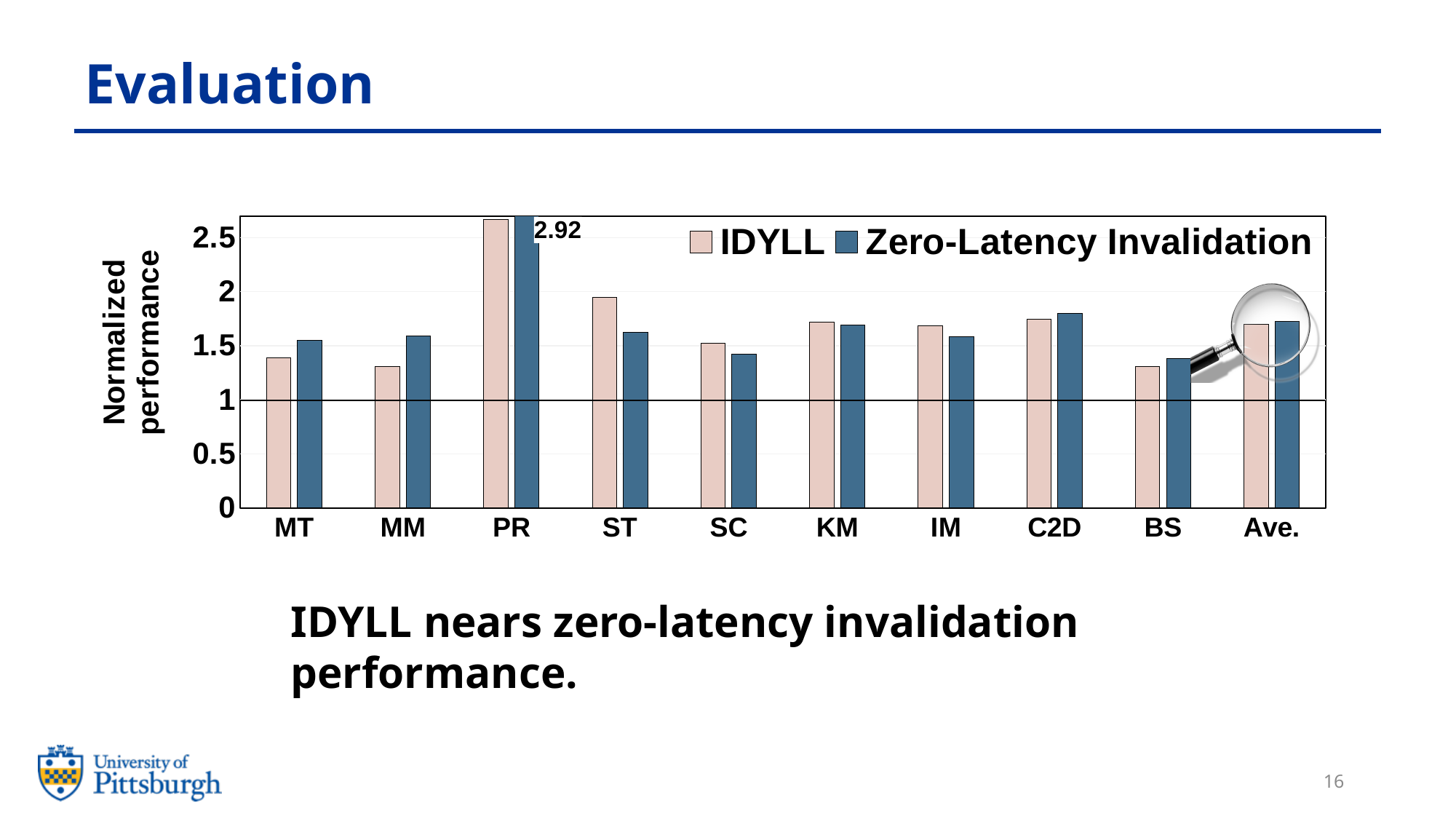
For MM, which series has the larger value, IDYLL or Zero-Latency Invalidation? Zero-Latency Invalidation What is the Zero-Latency Invalidation value for PR? 2.92 Is the Zero-Latency Invalidation value for C2D greater or less than 1.5? greater How many categories are shown on the x axis? 10 What kind of chart is shown on the slide? bar chart Which category has the highest Zero-Latency Invalidation value? PR What is the label on the y axis of the chart? Normalized performance Is the IDYLL value for MT greater or less than 1.5? less How many series does the legend list? 2 For ST, which series has the larger value, IDYLL or Zero-Latency Invalidation? IDYLL Which category has the highest IDYLL value? PR